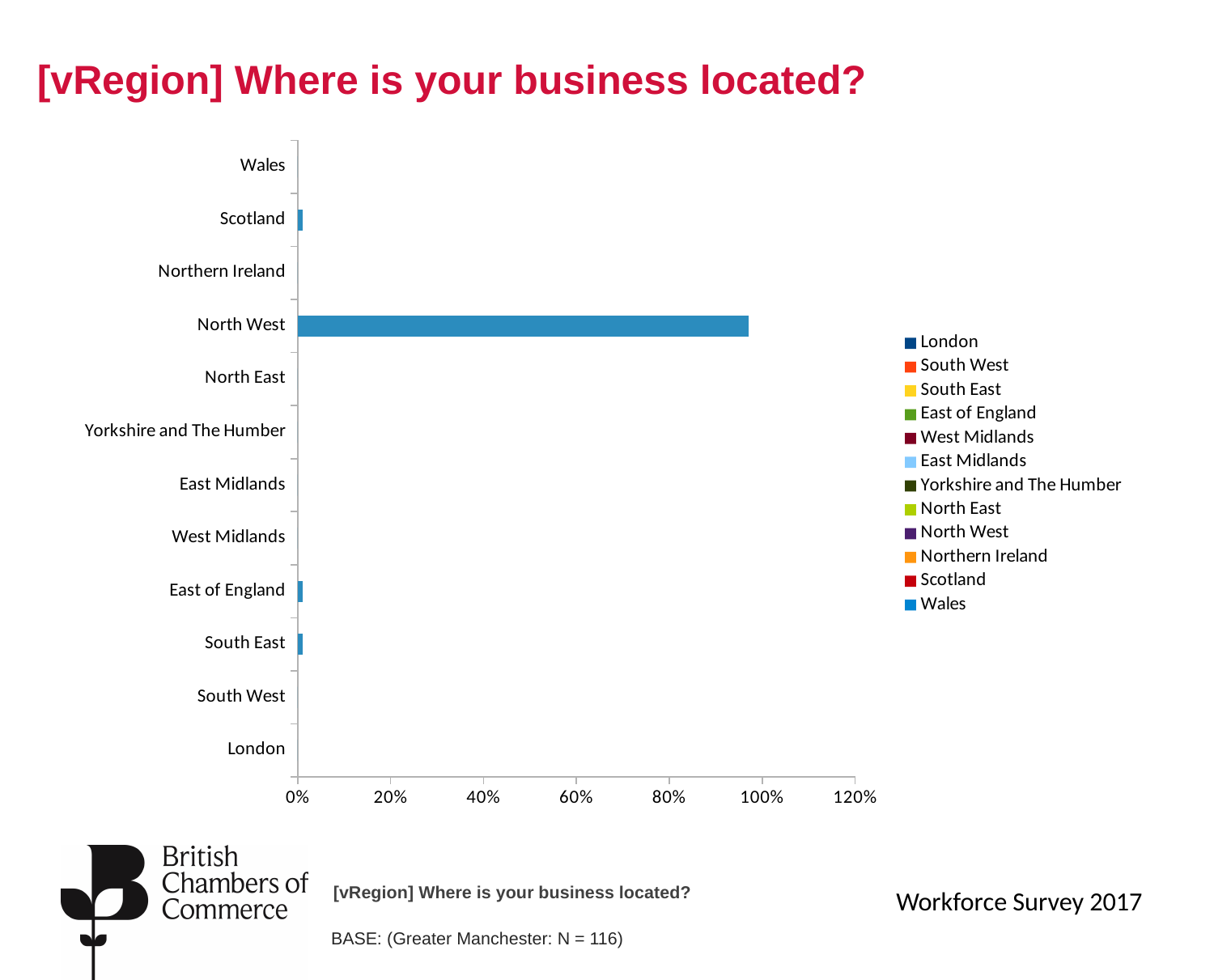
Is the value for East of England greater or less than 20%? less Is the value for North West greater or less than 100%? less How many entries does the chart's legend list? 12 Which is larger, the value for North West or the value for South East? North West Is the value for North West greater or less than 80%? greater What is the highest tick value shown on the horizontal axis of the chart? 120% What kind of chart is shown on the slide? bar chart Which is larger, the value for North West or the value for Scotland? North West What is the title of the slide containing the chart? [vRegion] Where is your business located? How many regions are listed on the vertical axis of the chart? 12 Which region has the highest value in the chart? North West